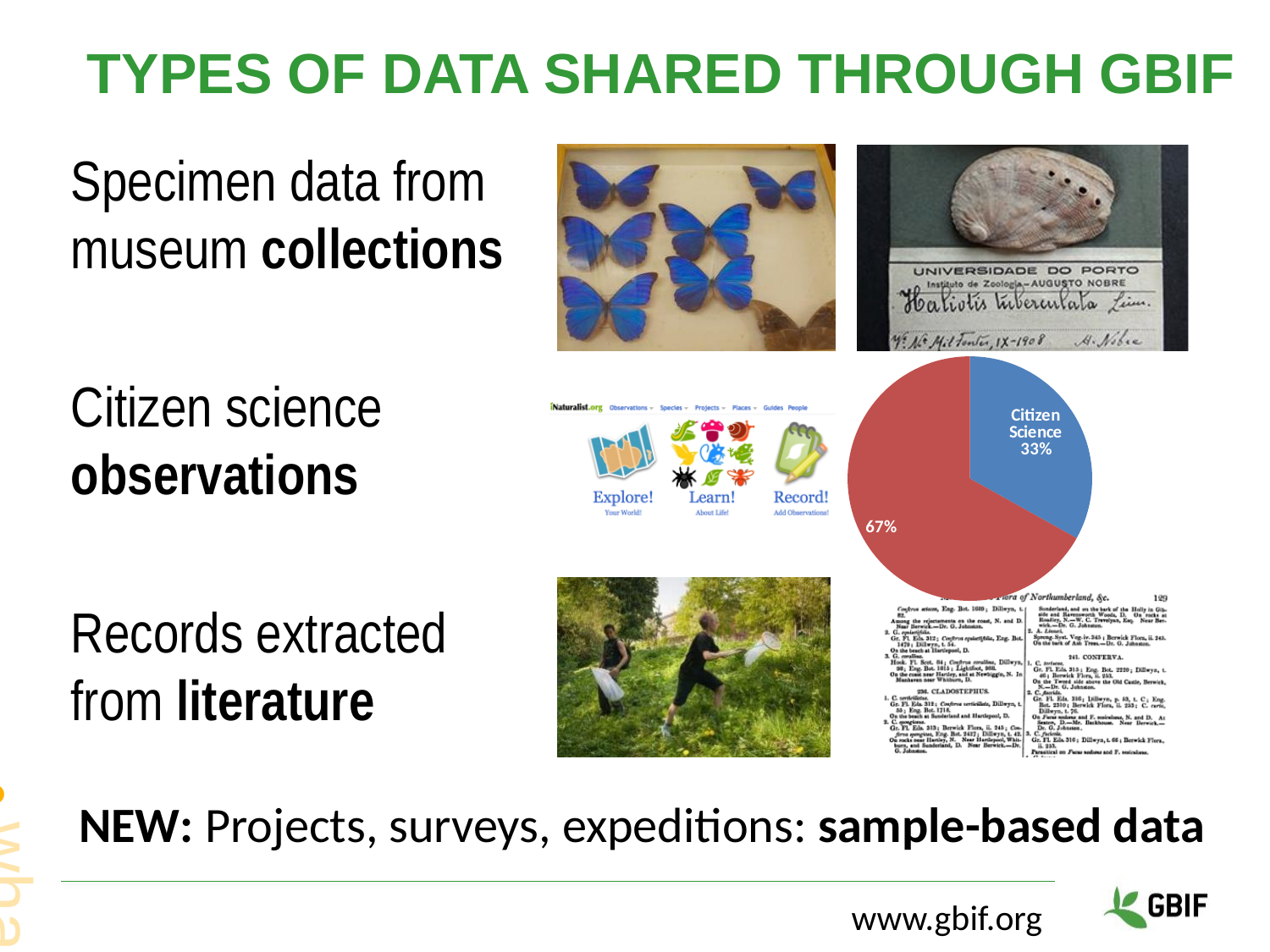
What colour is the Citizen Science slice of the pie chart? blue What do the two slices of the pie chart add up to? 100% What is the difference in percentage points between the red slice and the Citizen Science slice? 34 Is the Citizen Science share of the pie chart greater or less than 50%? less What percentage of the pie chart is labelled Citizen Science? 33% How many slices does the pie chart have? 2 What is the smallest slice in the pie chart? Citizen Science Which slice of the pie chart is larger, the Citizen Science slice or the red slice? the red slice What percentage is shown on the red slice of the pie chart? 67% What kind of chart is shown on the slide? pie chart